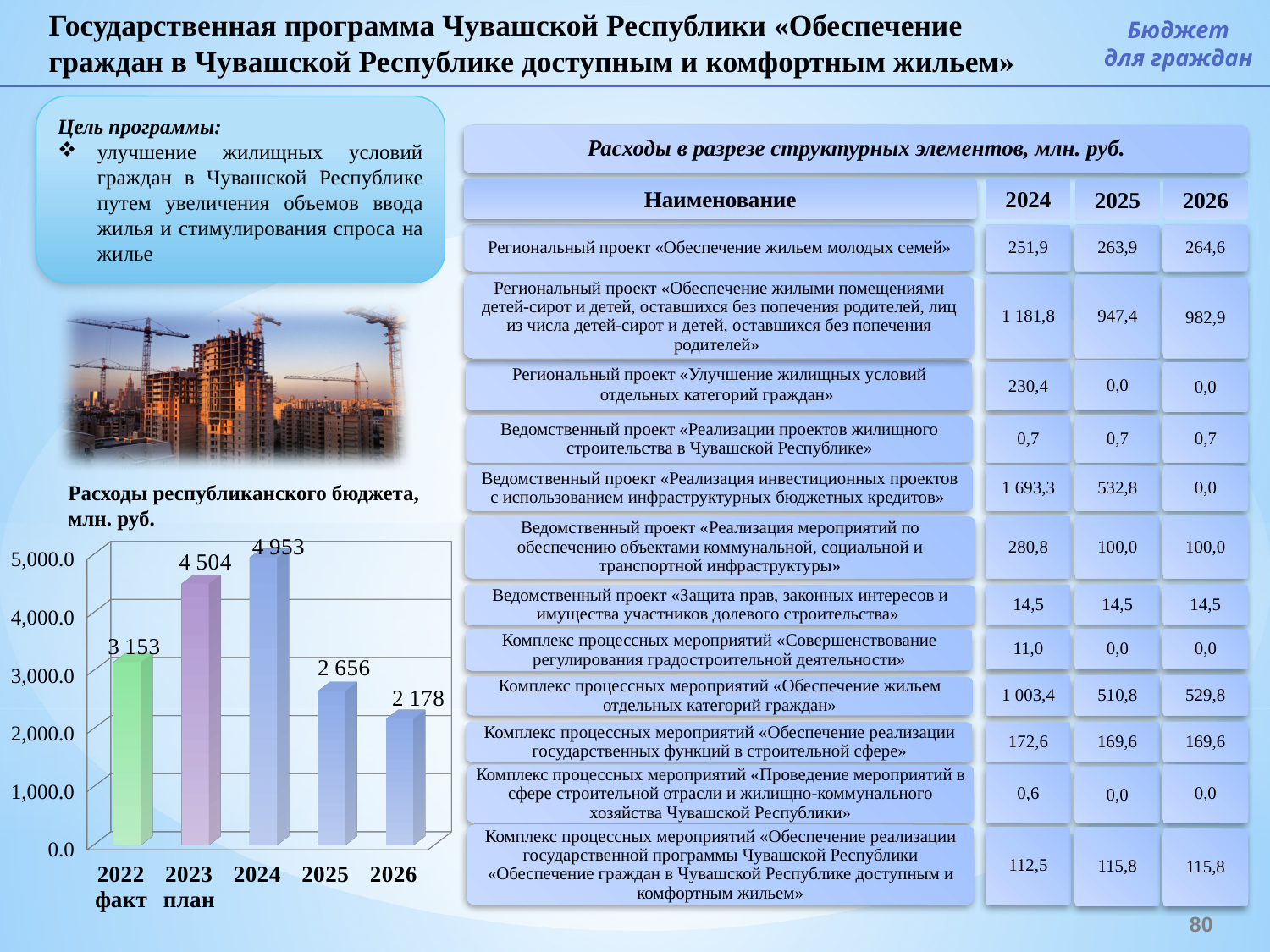
What is the value for 2025 in the chart 'Расходы республиканского бюджета, млн. руб.'? 2 656 Which year has the highest value in the chart 'Расходы республиканского бюджета, млн. руб.'? 2024 Which year has the lowest value in the chart 'Расходы республиканского бюджета, млн. руб.'? 2026 What is the value for 2022 in the chart 'Расходы республиканского бюджета, млн. руб.'? 3 153 What is the difference between the 2024 and 2023 values in the chart 'Расходы республиканского бюджета, млн. руб.'? 449 What kind of chart is 'Расходы республиканского бюджета, млн. руб.'? bar chart In the chart 'Расходы республиканского бюджета, млн. руб.', do the values rise or fall from 2024 to 2026? fall What is the difference between the 2022 and 2026 values in the chart 'Расходы республиканского бюджета, млн. руб.'? 975 In the chart 'Расходы республиканского бюджета, млн. руб.', which is larger: the value for 2023 or the value for 2025? 2023 How many years are shown in the chart 'Расходы республиканского бюджета, млн. руб.'? 5 In the chart 'Расходы республиканского бюджета, млн. руб.', is the value for 2023 greater or less than 4,000.0? greater What is the value for 2026 in the chart 'Расходы республиканского бюджета, млн. руб.'? 2 178